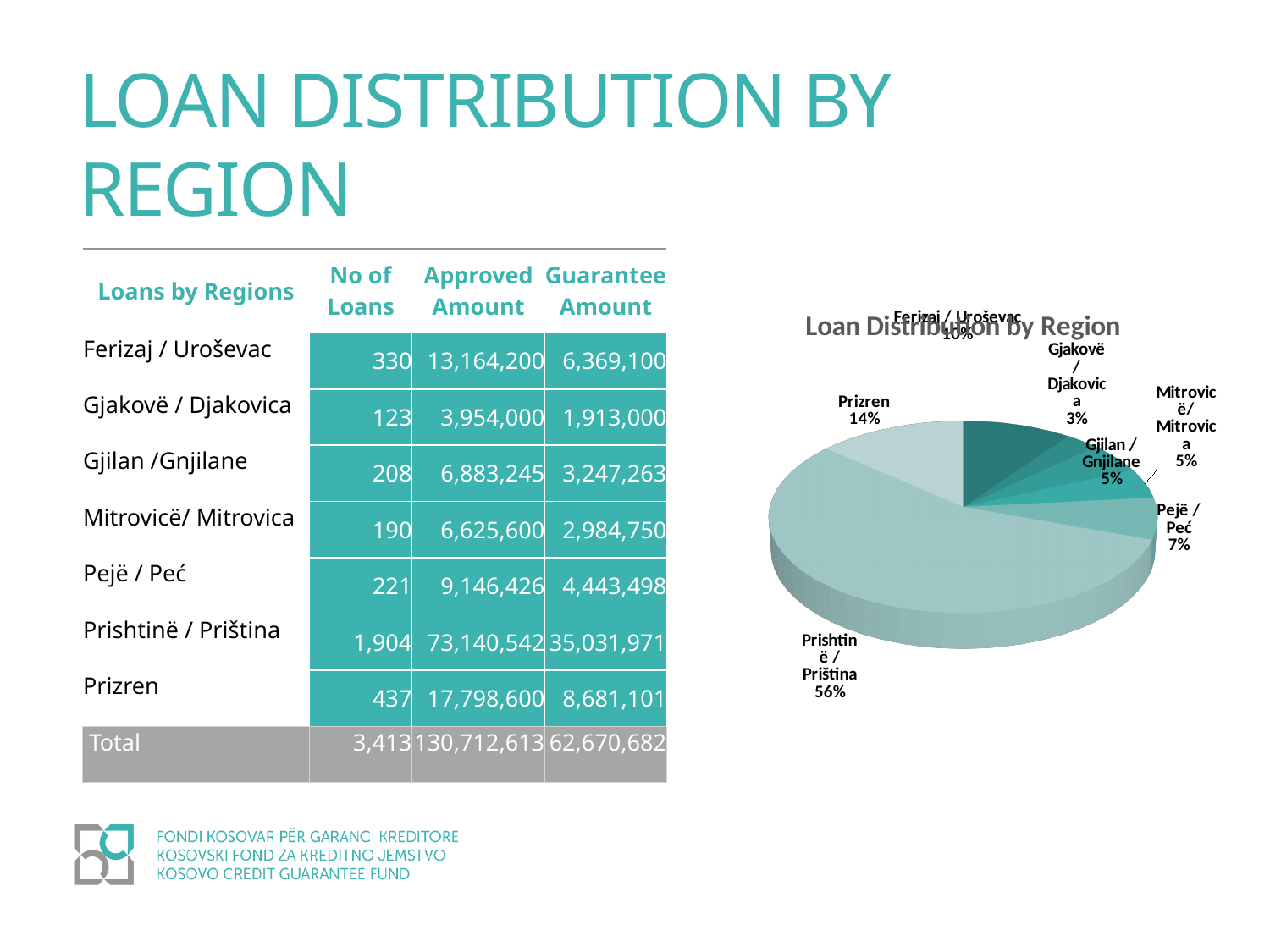
What share of the pie does Ferizaj / Uroševac have? 10% What share of the pie does Gjakovë / Djakovica have? 3% What is the title of the chart? Loan Distribution by Region How many regions are shown in the pie chart? 7 What share of the pie does Pejë / Peć have? 7% What kind of chart is shown on the slide? pie chart Which region has the smallest slice of the pie? Gjakovë / Djakovica Which slice is larger, Pejë / Peć or Mitrovicë/ Mitrovica? Pejë / Peć Which region has the largest slice of the pie? Prishtinë / Priština What is the difference in percentage points between the Prizren slice and the Ferizaj / Uroševac slice? 4